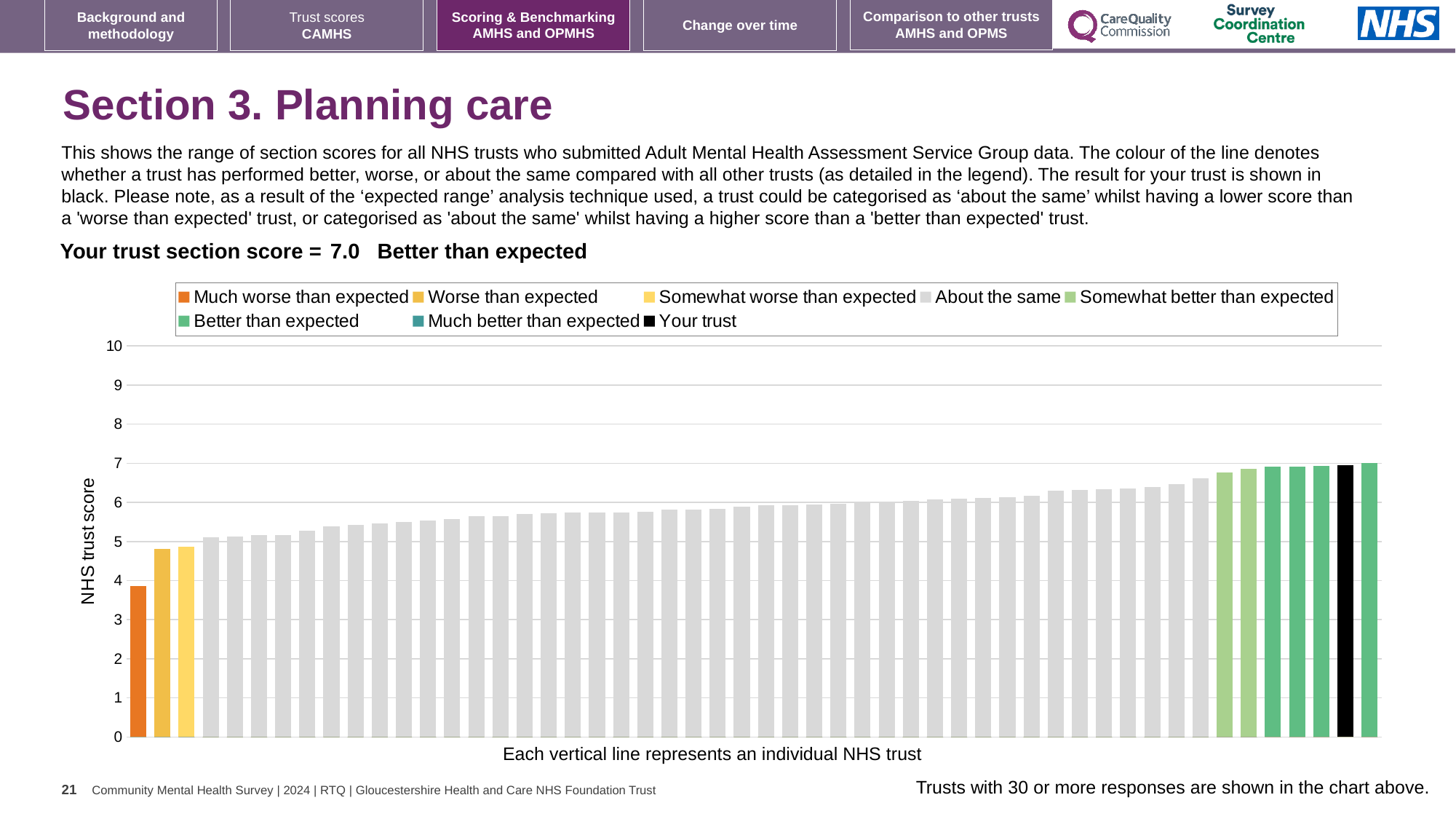
Is your trust's section score greater or less than 6? greater How many bars in the chart are coloured orange (Much worse than expected)? 1 What kind of chart is shown on the slide? bar chart How many entries does the chart legend list? 8 How many bars in the chart are coloured for 'Worse than expected'? 1 Which legend category does the lowest bar in the chart belong to? Much worse than expected Is the value of the highest bar in the chart greater or less than 8? less What is your trust's section score for Planning care? 7.0 What colour is used for 'Your trust' in the chart? black Is the value of the lowest bar in the chart greater or less than 5? less What is the label on the vertical axis of the chart? NHS trust score How is your trust categorised for the Planning care section score? Better than expected